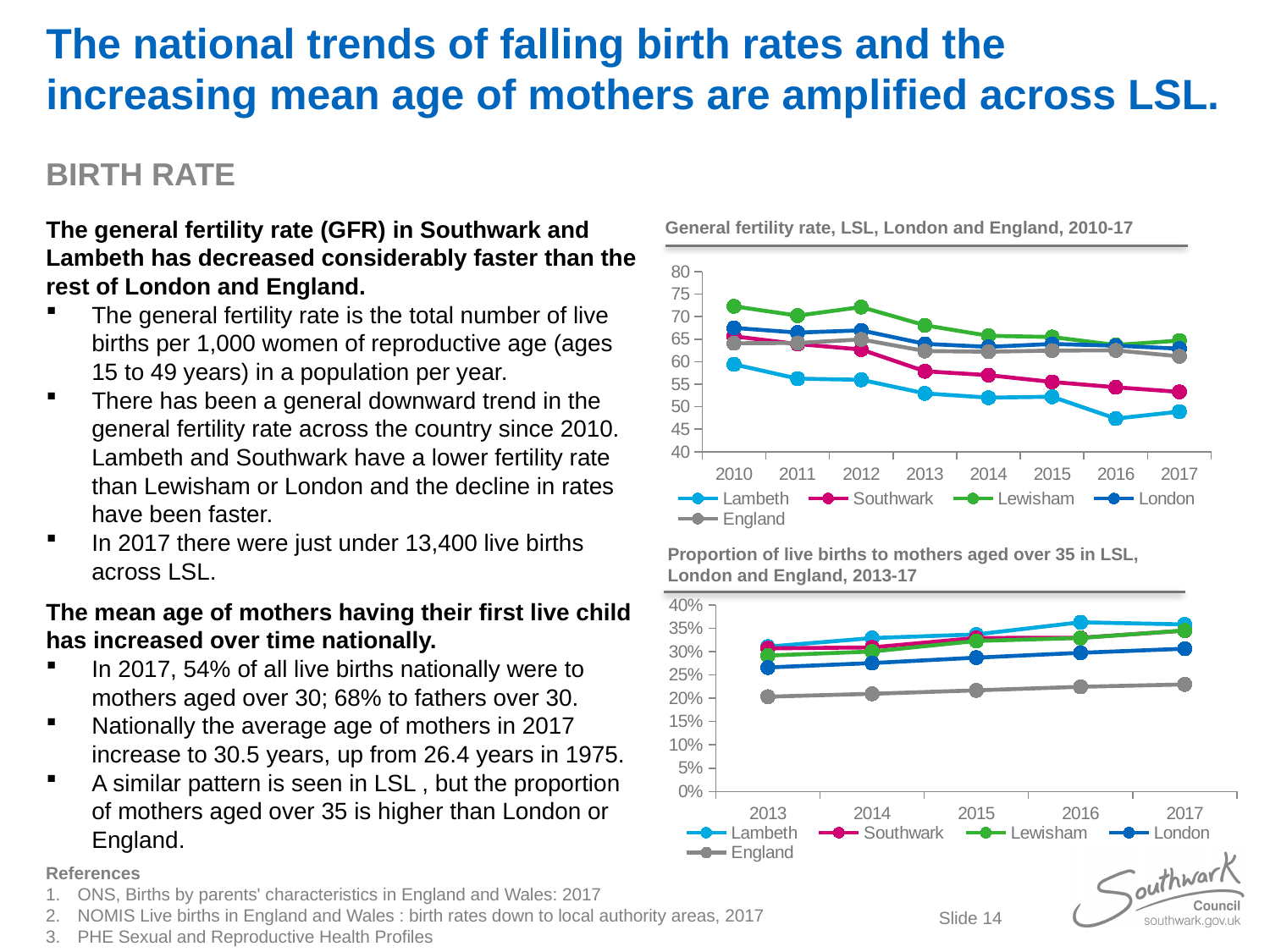
In the 'General fertility rate, LSL, London and England, 2010-17' chart, is the value for Lewisham in 2012 greater or less than 70? greater What type of chart is the 'General fertility rate, LSL, London and England, 2010-17' chart? line chart In the 'General fertility rate, LSL, London and England, 2010-17' chart, does the Lambeth line generally rise or fall from 2010 to 2017? fall In the 'Proportion of live births to mothers aged over 35' chart, which is larger in 2017, Lambeth or London? Lambeth In the 'Proportion of live births to mothers aged over 35' chart, which area has the lowest proportion across all years? England In the 'General fertility rate, LSL, London and England, 2010-17' chart, is the value for Lambeth in 2016 greater or less than 50? less In the 'General fertility rate, LSL, London and England, 2010-17' chart, which area has the lowest fertility rate in 2016? Lambeth How many years are plotted on the x axis of the 'General fertility rate, LSL, London and England, 2010-17' chart? 8 In the 'General fertility rate, LSL, London and England, 2010-17' chart, which area has the highest fertility rate in 2010? Lewisham How many series does the legend of the 'General fertility rate, LSL, London and England, 2010-17' chart list? 5 In the 'Proportion of live births to mothers aged over 35' chart, does the England line rise or fall from 2013 to 2017? rise In the 'Proportion of live births to mothers aged over 35' chart, is the value for England in 2017 greater or less than 25%? less